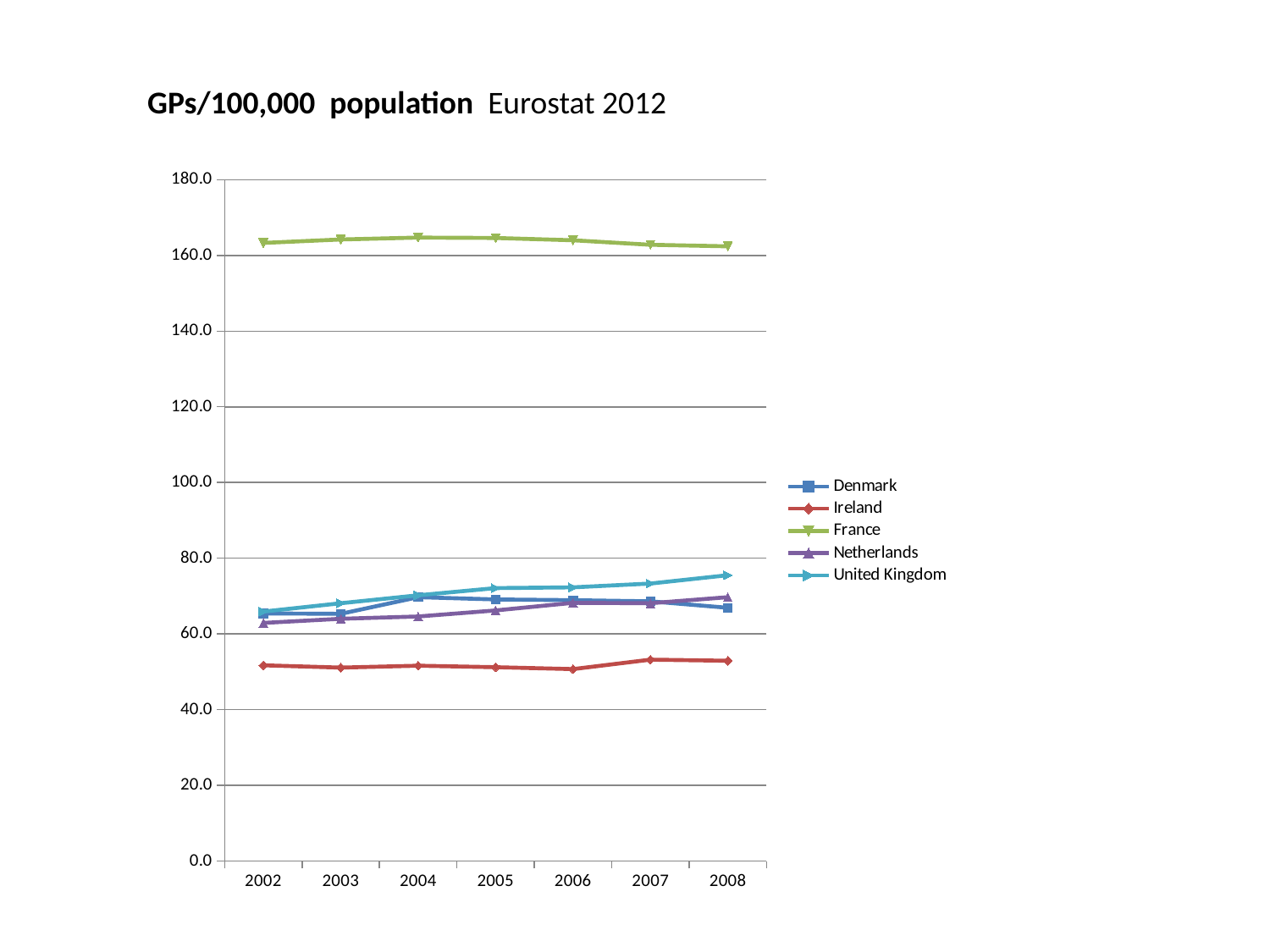
How many years are shown on the x axis? 7 In 2008, which is larger: the value for the United Kingdom or the value for Ireland? United Kingdom Which country has the highest number of GPs per 100,000 population across all years shown? France Is the value for Ireland in 2006 greater or less than 60? less Is the value for Ireland in 2002 greater or less than 40? greater What kind of chart is shown on the slide? line chart Does the value for the United Kingdom rise or fall from 2002 to 2008? rise Is the value for France in 2004 greater or less than 160? greater How many series does the legend list? 5 What is the title of the chart? GPs/100,000 population Eurostat 2012 Which country has the lowest number of GPs per 100,000 population across all years shown? Ireland